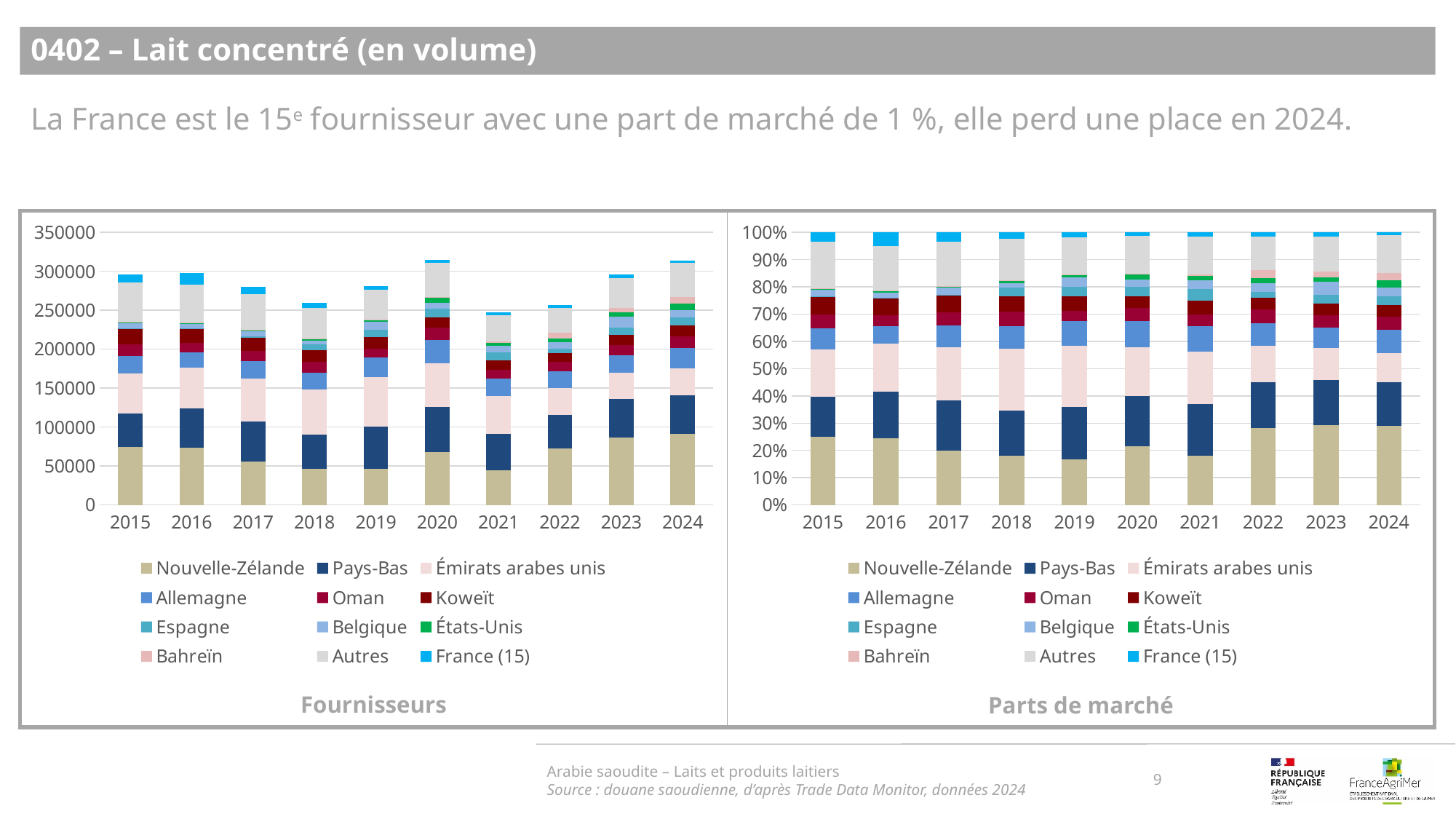
What kind of chart is the 'Fournisseurs' chart on the left? Stacked bar chart In the 'Parts de marché' chart, is the share of Nouvelle-Zélande in 2019 greater or less than 20%? less Which series is at the bottom of each stacked bar in the 'Fournisseurs' chart? Nouvelle-Zélande In the 'Fournisseurs' chart, is the value for Nouvelle-Zélande in 2015 greater or less than 50000? greater In the 'Fournisseurs' chart, is the total stacked value larger in 2020 or in 2021? 2020 In the 'Parts de marché' chart, does the share of Nouvelle-Zélande rise or fall from 2021 to 2024? Rise In the 'Fournisseurs' chart, which year has the lowest total stacked value? 2021 How many series does the legend of the 'Fournisseurs' chart list? 12 What is the title shown under the right-hand chart? Parts de marché How many years are shown on the x axis of the 'Parts de marché' chart? 10 In the 'Fournisseurs' chart, is the total stacked value for 2020 greater or less than 300000? greater